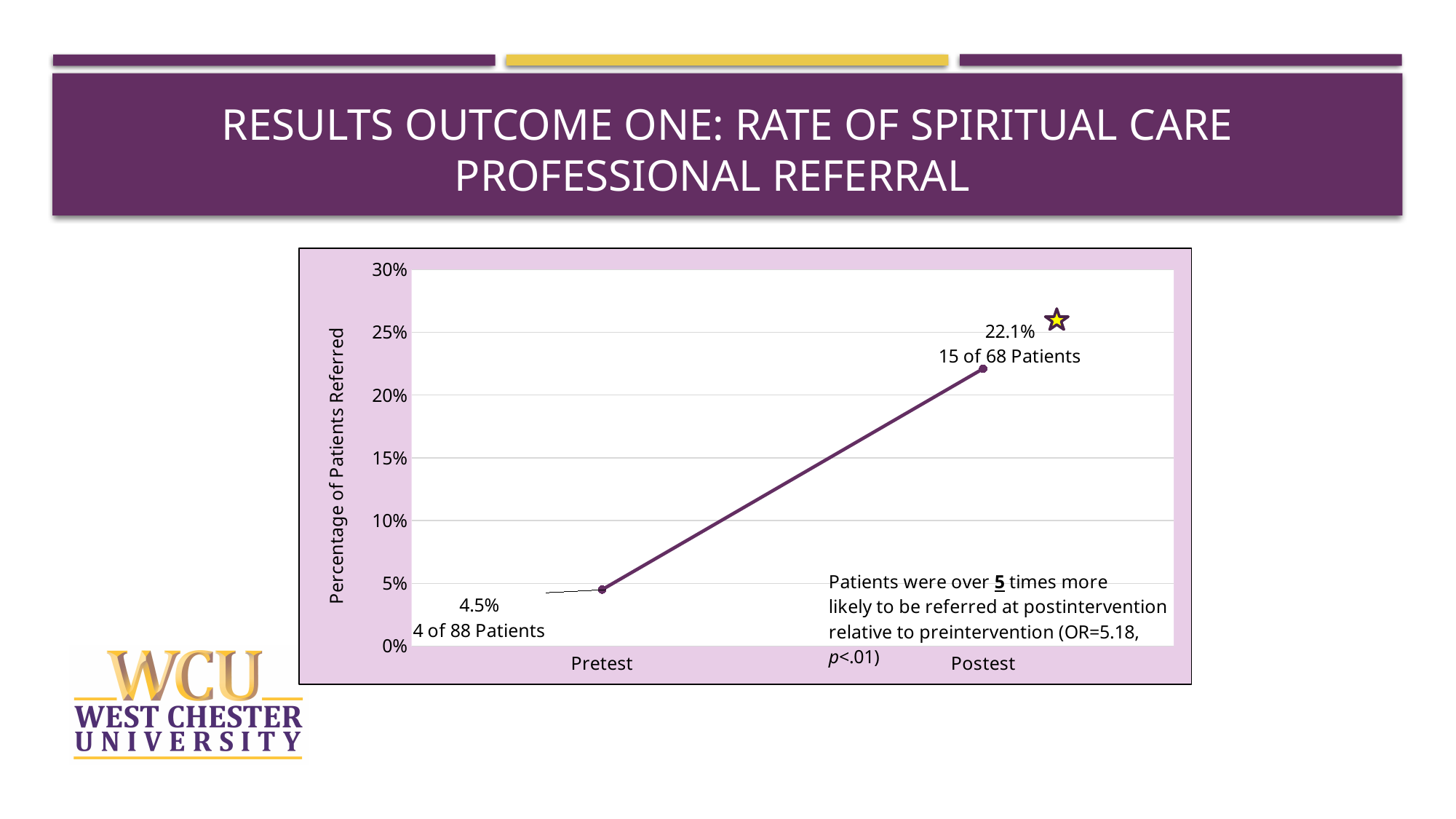
Is the value for Pretest greater or less than 5%? less How many patients were referred at Postest, according to the data label? 15 of 68 Patients How many patients were referred at Pretest, according to the data label? 4 of 88 Patients Is the value for Postest greater or less than 20%? greater What is the percentage of patients referred at Pretest? 4.5% What kind of chart is shown on the slide? line chart Which time point has the higher percentage of patients referred? Postest What is the difference in percentage points between the Postest and Pretest referral rates? 17.6 How many data points are plotted on the chart? 2 Which time point has the lower percentage of patients referred? Pretest What is the label of the vertical axis? Percentage of Patients Referred What is the percentage of patients referred at Postest? 22.1%